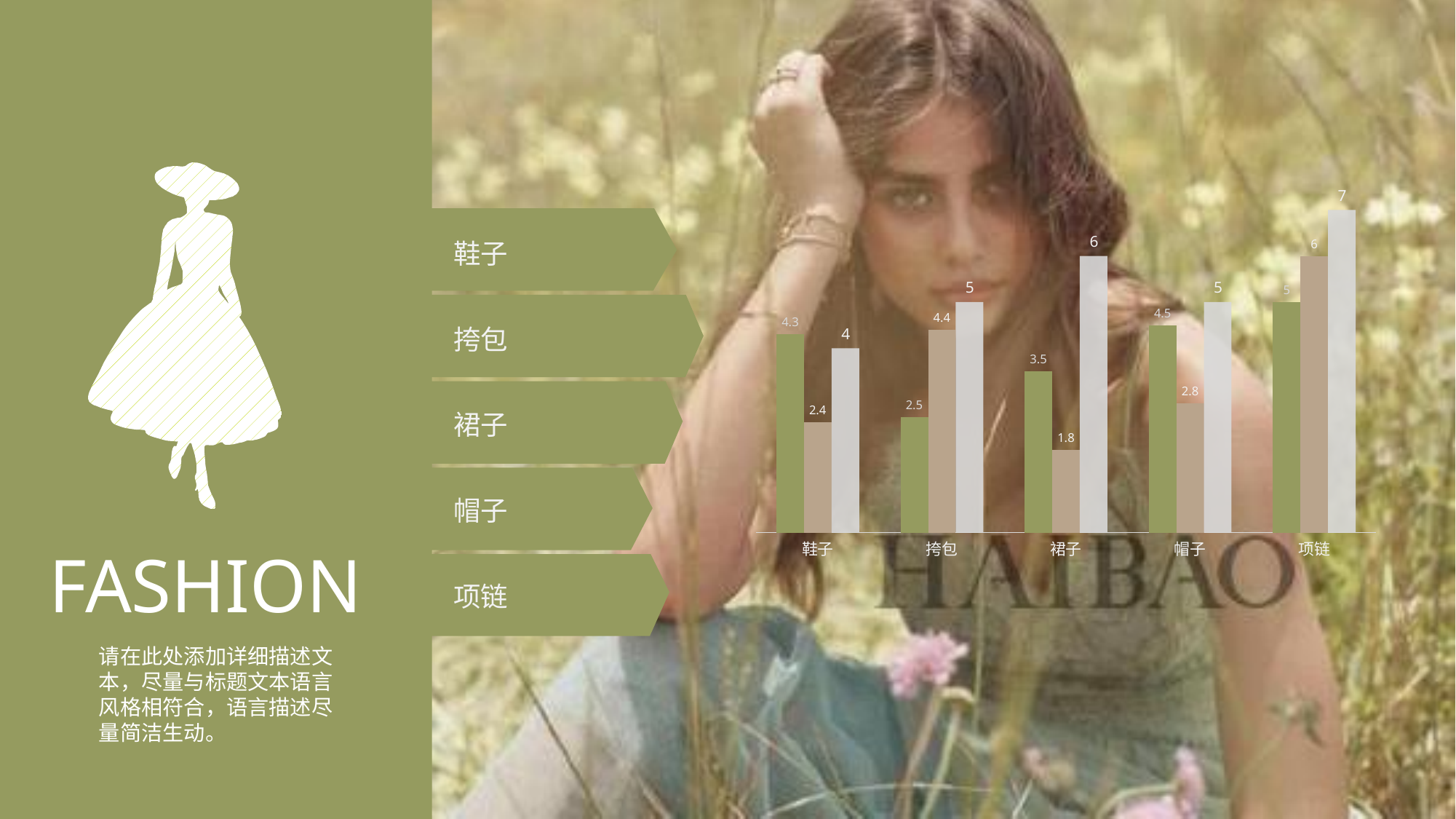
Which is larger for 挎包: the green bar or the light gray bar? the light gray bar What is the difference between the green bars for 帽子 and 裙子? 1 What is the value of the light gray bar for 项链? 7 What is the value of the green bar for 鞋子? 4.3 What is the difference between the light gray bar and the tan bar for 裙子? 4.2 How many categories are shown on the x axis of the chart? 5 Which category has the highest light gray bar? 项链 What is the value of the tan (brown) bar for 裙子? 1.8 What is the value of the tan (brown) bar for 帽子? 2.8 How many bars are shown for each category in the chart? 3 Which category has the lowest tan (brown) bar? 裙子 What kind of chart is shown on the slide? bar chart